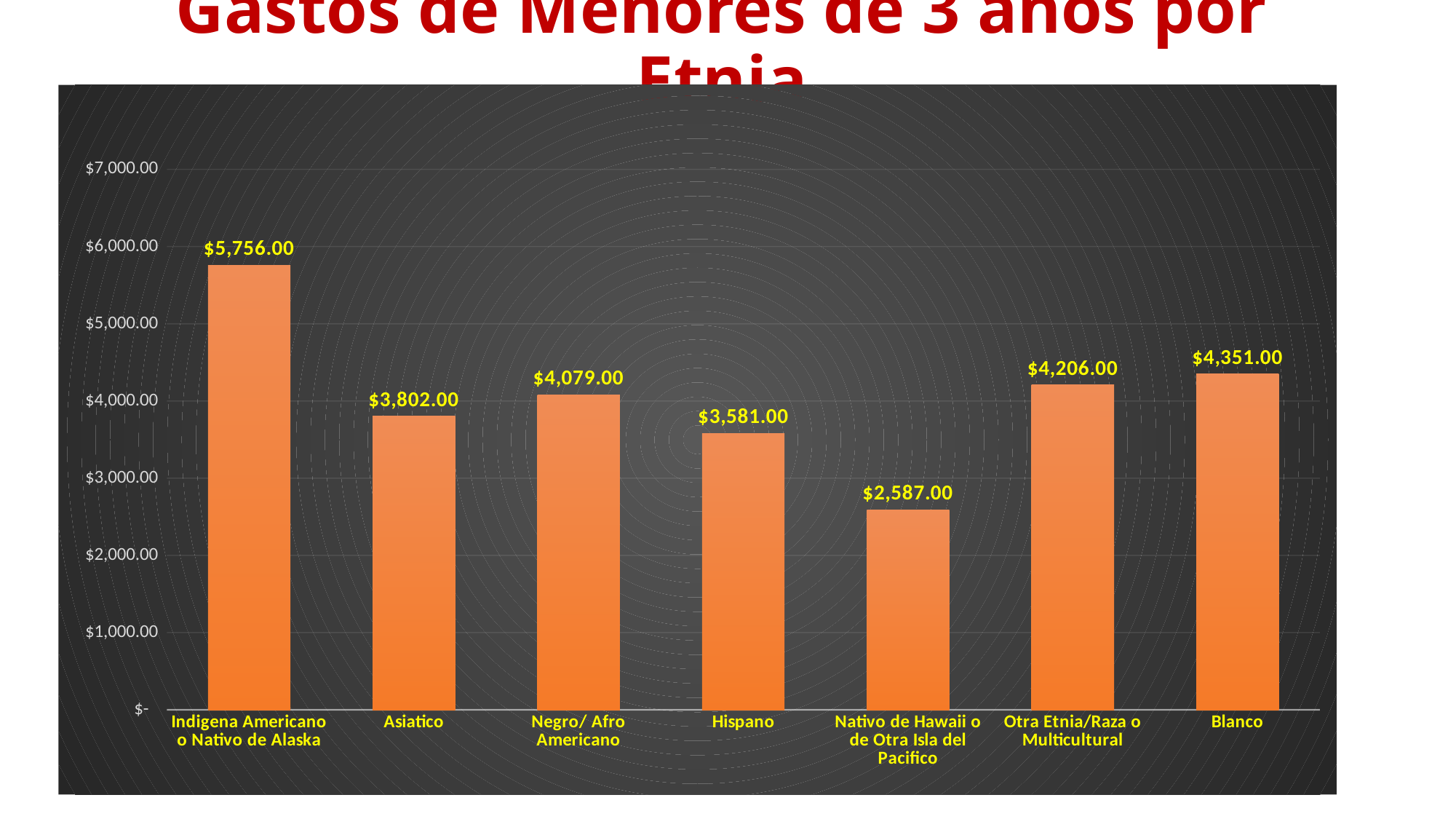
What is the difference between the values for Indigena Americano o Nativo de Alaska and Blanco? $1,405.00 Which is larger, the value for Otra Etnia/Raza o Multicultural or the value for Asiatico? Otra Etnia/Raza o Multicultural What is the value for Hispano? $3,581.00 Which category has the lowest value? Nativo de Hawaii o de Otra Isla del Pacifico How many categories are shown on the x axis? 7 What colour are the bars in the chart? orange Which category has the highest value? Indigena Americano o Nativo de Alaska What is the difference between the values for Negro/ Afro Americano and Asiatico? $277.00 What is the value for Blanco? $4,351.00 What kind of chart is shown on the slide? bar chart What is the value for Nativo de Hawaii o de Otra Isla del Pacifico? $2,587.00 Is the value for Hispano greater or less than $4,000.00? less